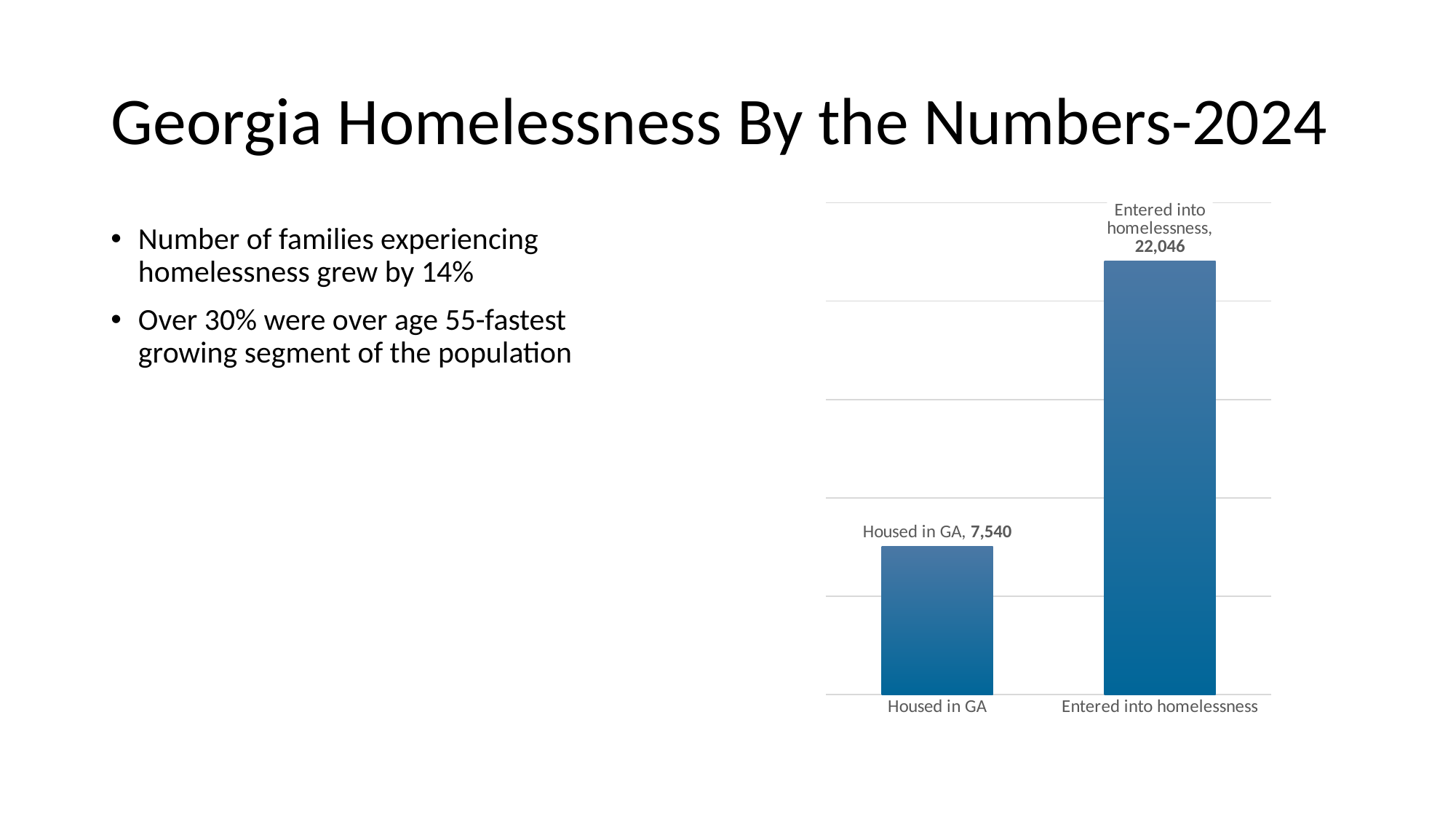
Which is larger, the value for Housed in GA or the value for Entered into homelessness? Entered into homelessness Which category has the highest value? Entered into homelessness What colour are the bars in the chart? blue What is the total of the two values shown in the chart? 29,586 How many categories are shown in the chart? 2 What is the value for Housed in GA? 7,540 What is the title of the slide? Georgia Homelessness By the Numbers-2024 What is the difference between the value for Entered into homelessness and the value for Housed in GA? 14,506 What is the value for Entered into homelessness? 22,046 What kind of chart is shown on the slide? bar chart Which category has the lowest value? Housed in GA